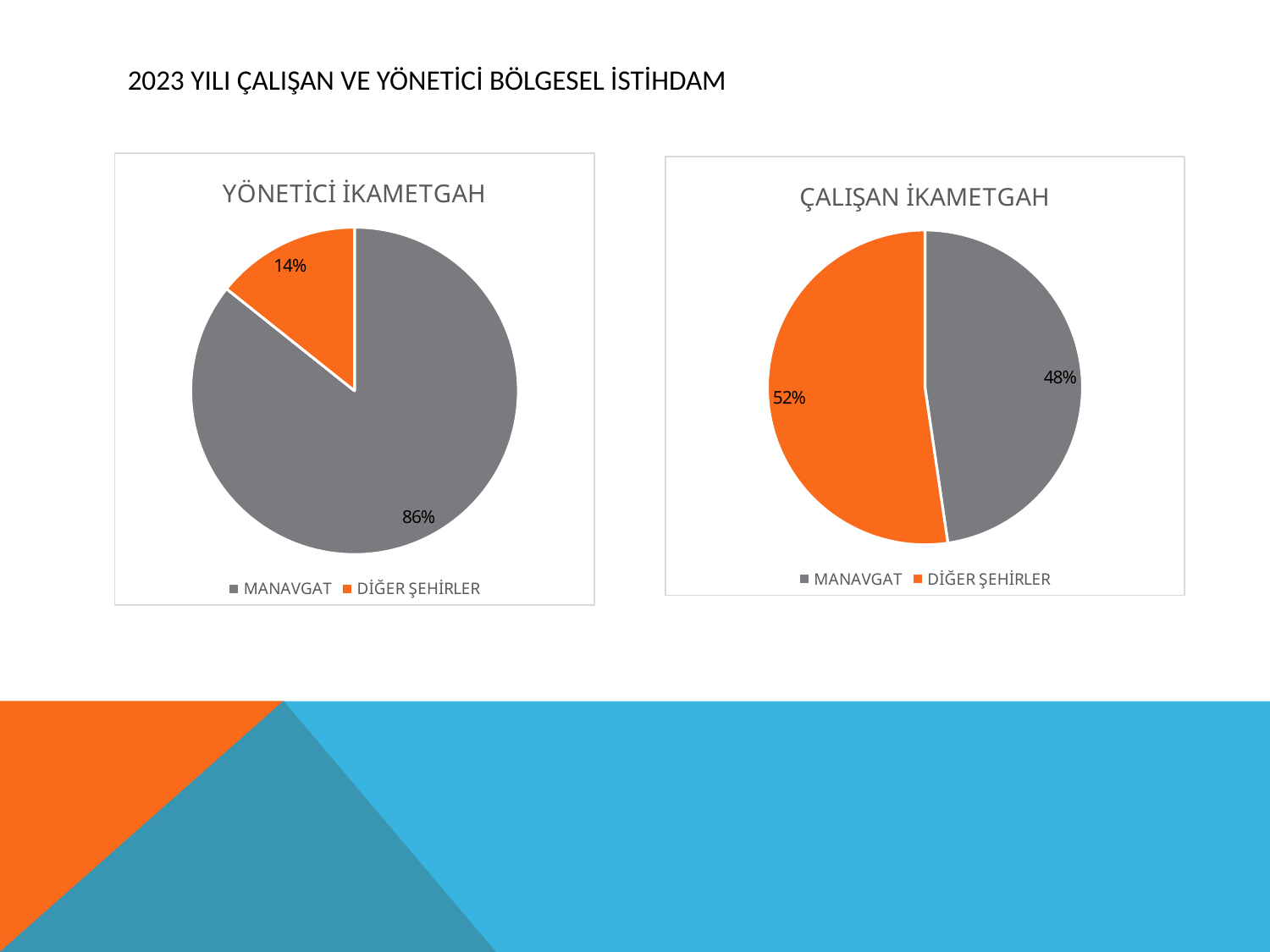
In the ÇALIŞAN İKAMETGAH chart, which category has the smallest slice? MANAVGAT In the ÇALIŞAN İKAMETGAH chart, what share does MANAVGAT have? 48% In the ÇALIŞAN İKAMETGAH chart, what is the difference between the DİĞER ŞEHİRLER and MANAVGAT shares? 4% In the ÇALIŞAN İKAMETGAH chart, what share does DİĞER ŞEHİRLER have? 52% In the YÖNETİCİ İKAMETGAH chart, what share does DİĞER ŞEHİRLER have? 14% How many categories does the legend of the ÇALIŞAN İKAMETGAH chart list? 2 In the YÖNETİCİ İKAMETGAH chart, what is the difference between the MANAVGAT and DİĞER ŞEHİRLER shares? 72% In the YÖNETİCİ İKAMETGAH chart, which category has the largest slice? MANAVGAT In the YÖNETİCİ İKAMETGAH chart, what colour is the DİĞER ŞEHİRLER slice? Orange In the ÇALIŞAN İKAMETGAH chart, which is larger, MANAVGAT or DİĞER ŞEHİRLER? DİĞER ŞEHİRLER What kind of chart is the YÖNETİCİ İKAMETGAH chart? Pie chart